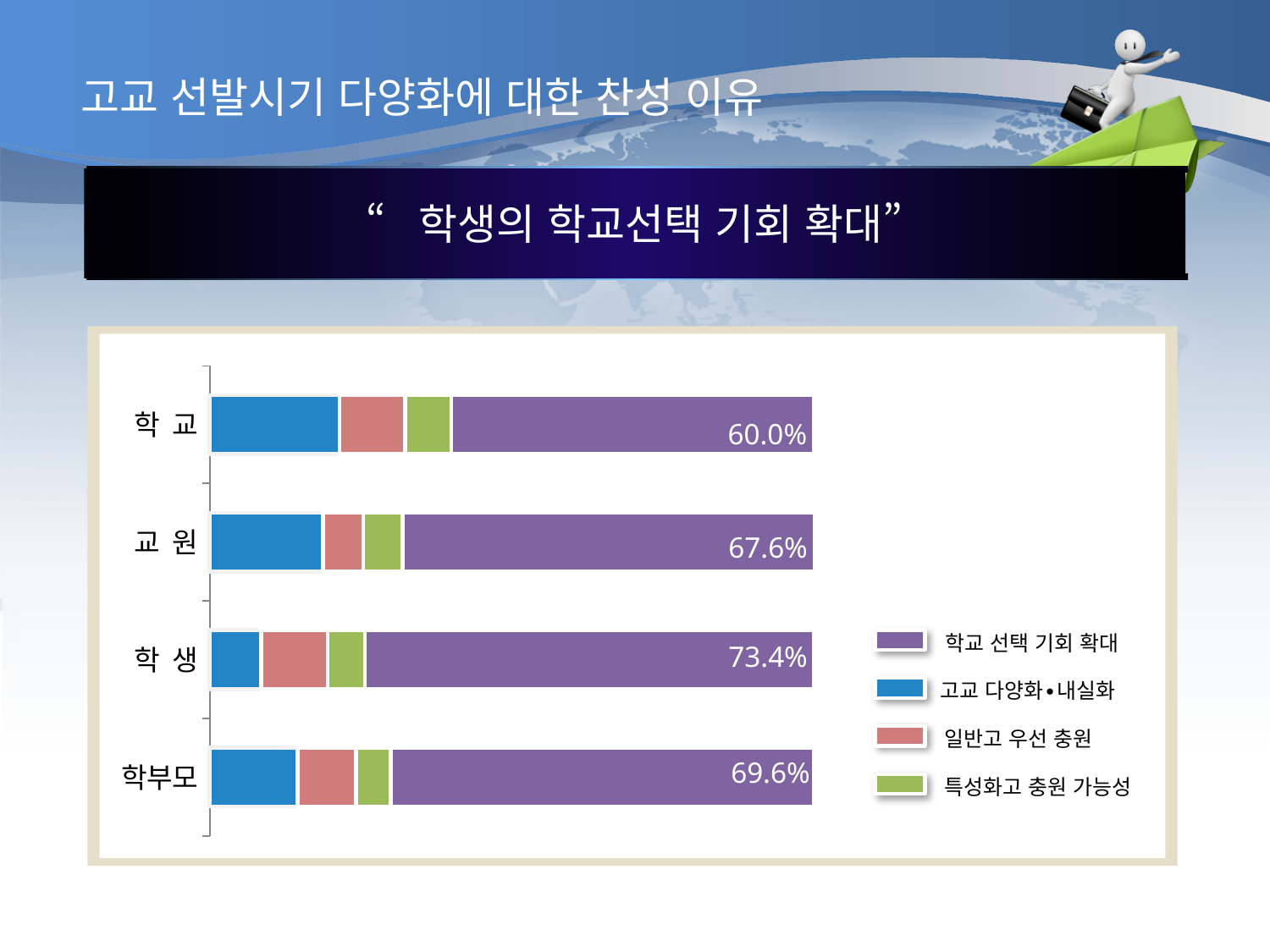
How many series does the legend list? 4 What is the value of 학교 선택 기회 확대 for 교원? 67.6% What is the difference between the 학교 선택 기회 확대 values for 학생 and 학교? 13.4 percentage points Which group has the highest value for 학교 선택 기회 확대? 학생 How many groups (categories) are shown on the chart? 4 Which is larger, the 학교 선택 기회 확대 value for 학부모 or for 교원? 학부모 What is the value of 학교 선택 기회 확대 for 학교? 60.0% Which group has the larger 고교 다양화•내실화 segment, 학교 or 학생? 학교 Which group has the lowest value for 학교 선택 기회 확대? 학교 What is the value of 학교 선택 기회 확대 for 학부모? 69.6% What kind of chart is shown on the slide? Stacked bar chart What is the value of 학교 선택 기회 확대 for 학생? 73.4%